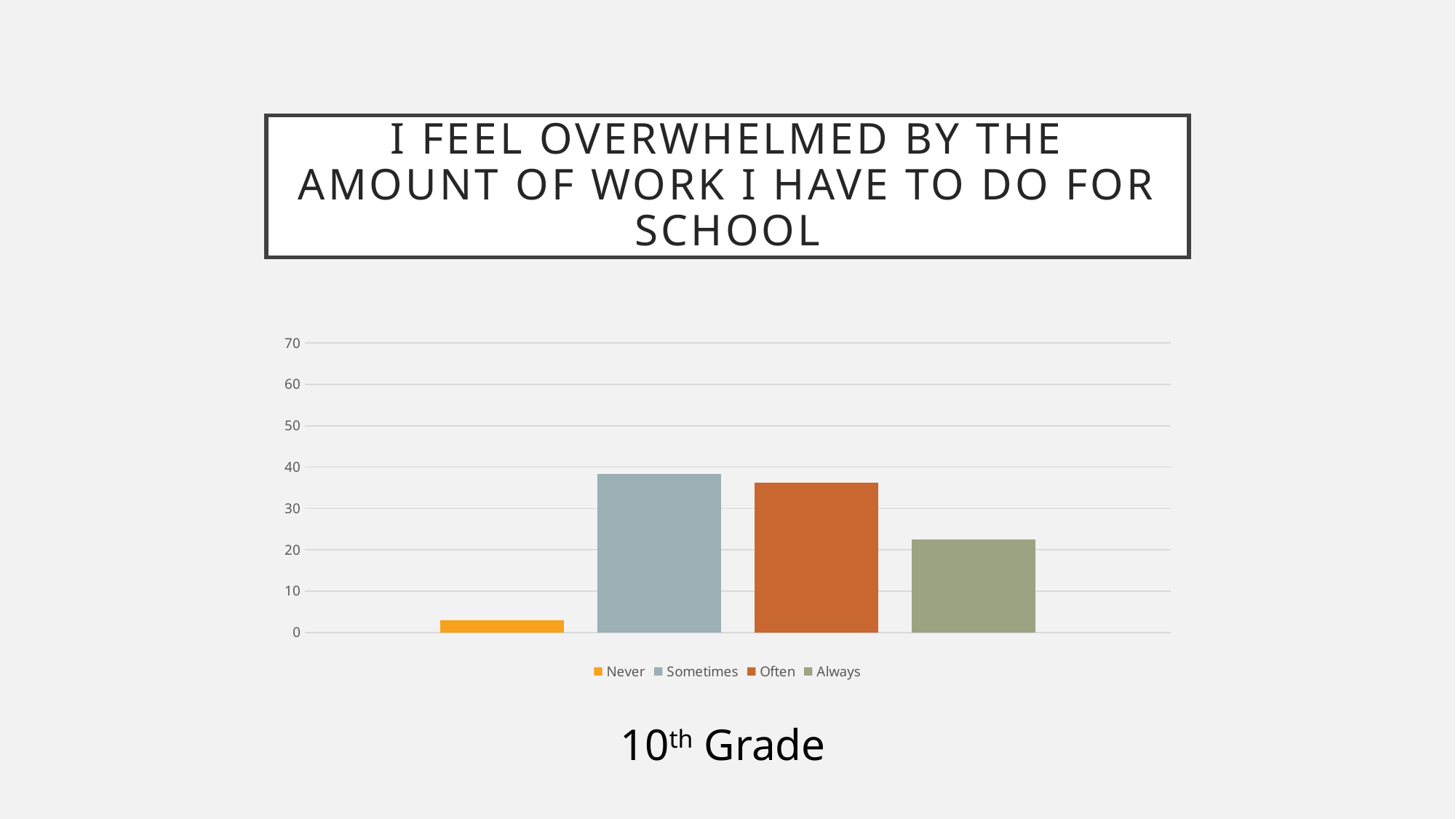
Is the value for Never greater or less than 10? less Is the value for Always greater or less than 20? greater How many series does the legend list? 4 How many bars are plotted in the chart? 4 Which is larger, the value for Often or the value for Always? Often Which grade level does the chart on the slide refer to? 10th Grade Is the value for Always greater or less than 30? less Which response category has the lowest bar? Never What kind of chart is shown on the slide? bar chart